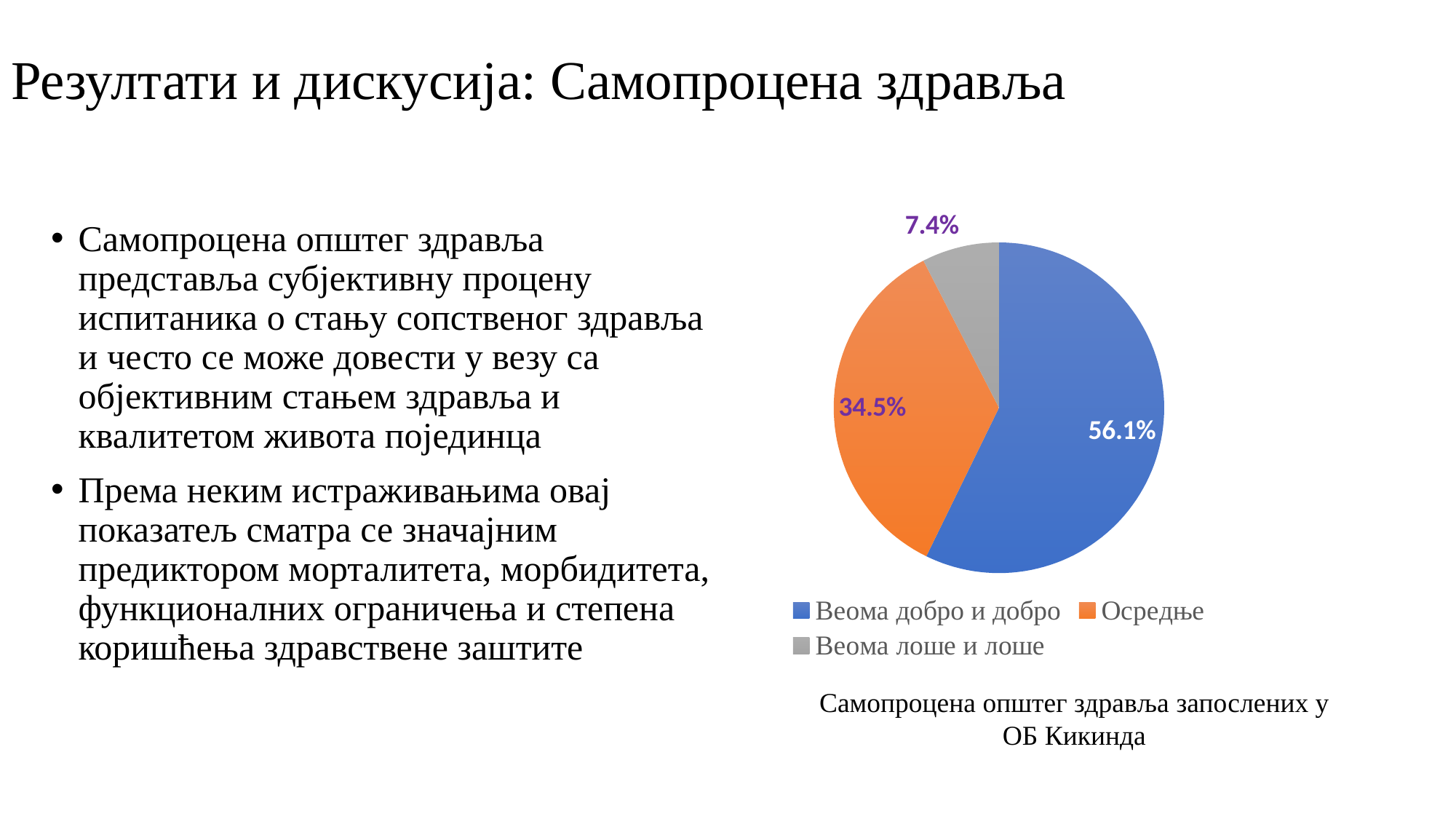
Which is larger, the slice for "Осредње" or the slice for "Веома лоше и лоше"? Осредње What is the difference in percentage points between "Веома добро и добро" and "Осредње"? 21.6 Which category has the largest slice of the pie? Веома добро и добро How many slices does the pie chart have? 3 Which category has the smallest slice of the pie? Веома лоше и лоше What share of the pie does "Веома лоше и лоше" have? 7.4% What kind of chart is shown on the slide? pie chart What share of the pie does "Веома добро и добро" have? 56.1% What colour is the slice for "Осредње"? orange What is the difference in percentage points between "Осредње" and "Веома лоше и лоше"? 27.1 What is the caption below the pie chart? Самопроцена општег здравља запослених у ОБ Кикинда What share of the pie does "Осредње" have? 34.5%